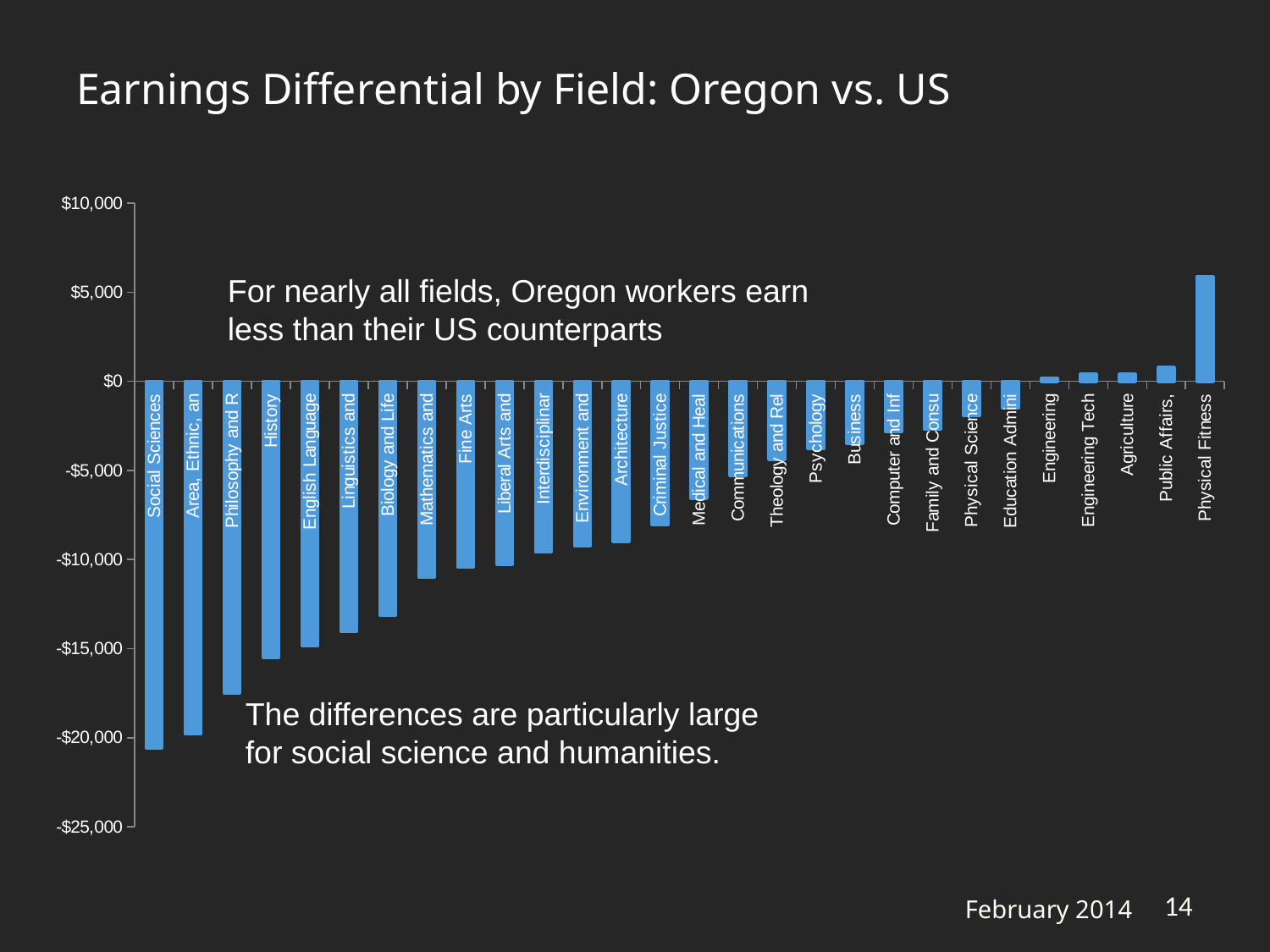
Which has the larger earnings differential, Psychology or Communications? Psychology Is the value for History greater or less than -$15,000? less What kind of chart is shown on the slide? Bar chart According to the text on the chart, for which fields are the differences particularly large? Social science and humanities Is the value for Physical Fitness greater or less than $5,000? greater Is the value for Biology and Life greater or less than -$15,000? greater Do the values generally rise or fall moving from left to right along the x axis? Rise What is the title of the chart? Earnings Differential by Field: Oregon vs. US Which field has the lowest (most negative) earnings differential? Social Sciences How many fields (categories) are plotted in the chart? 28 Which field has the highest (most positive) earnings differential? Physical Fitness